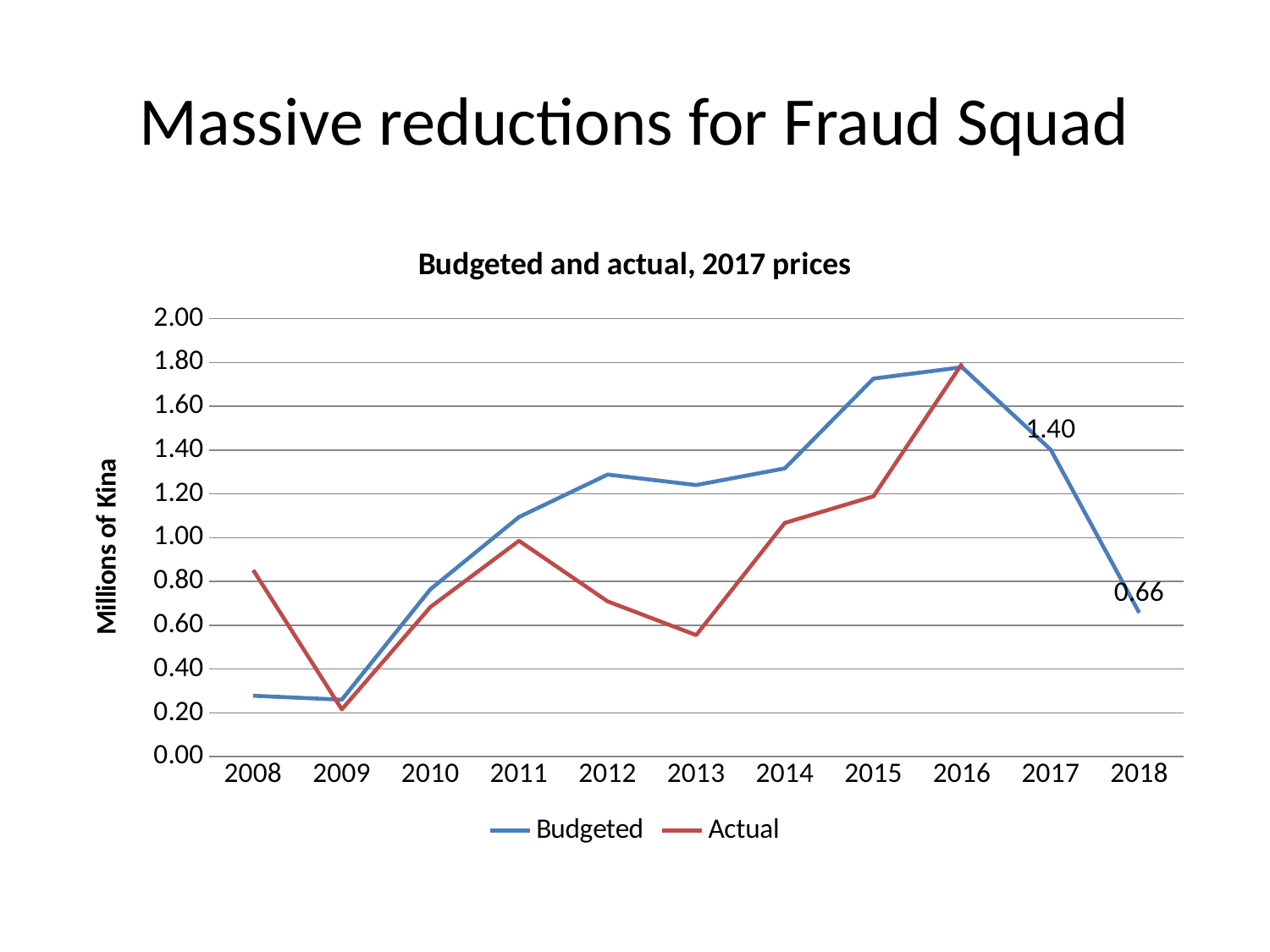
How many series does the legend list? 2 Is the Actual value for 2013 greater or less than 0.80? less Is the Budgeted value for 2015 greater or less than 1.60? greater In which year does the Actual series reach its highest value? 2016 By how much does the Budgeted value fall from 2017 to 2018? 0.74 What is the Budgeted value for 2017? 1.40 What kind of chart is shown on the slide? Line chart In 2008, which is larger, the Budgeted or the Actual value? Actual How many years are shown on the x axis? 11 In which year is the Actual series at its lowest? 2009 In 2012, which is larger, the Budgeted or the Actual value? Budgeted What is the Budgeted value for 2018? 0.66